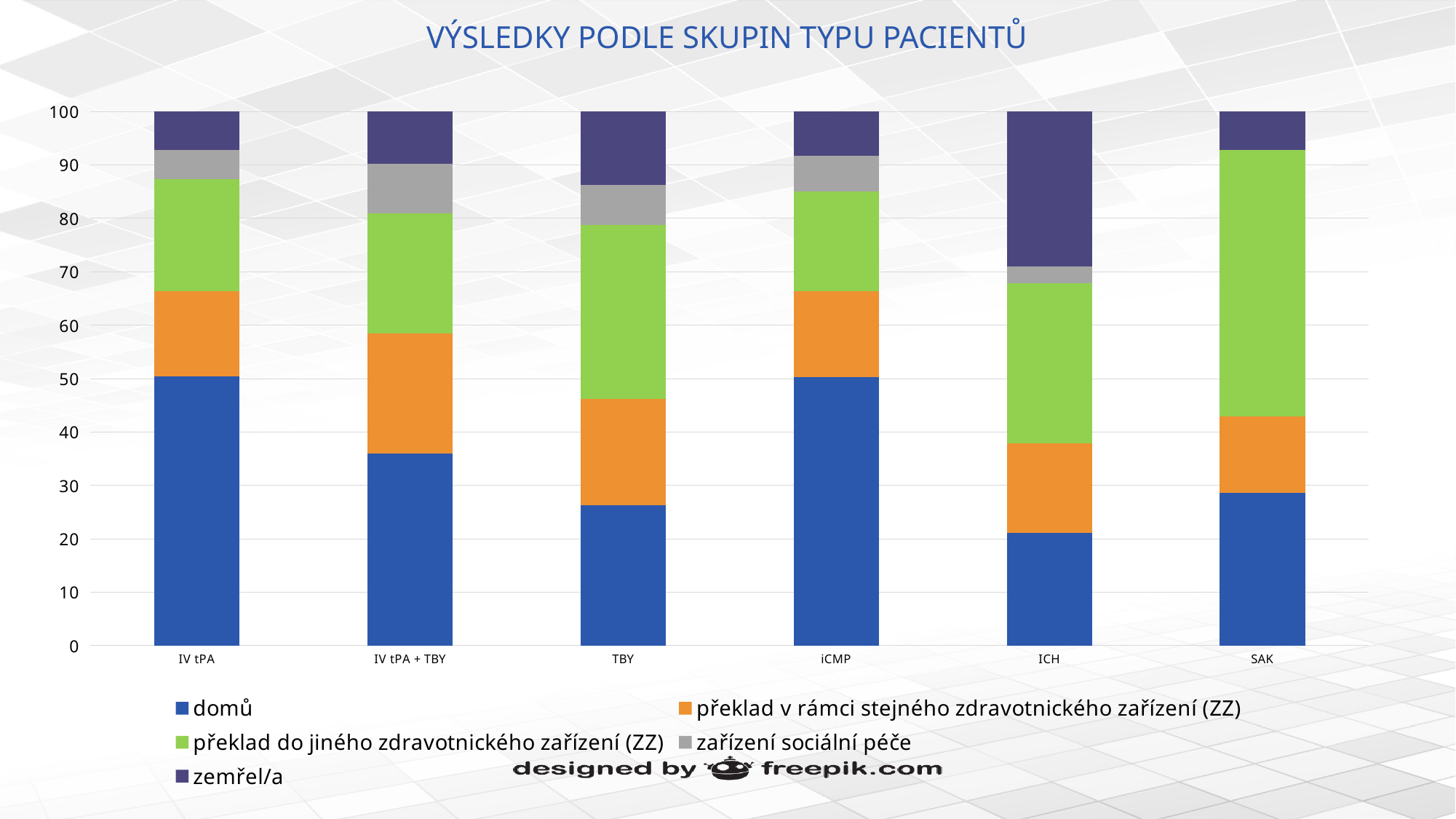
Which colour represents the series 'zemřel/a' in the legend? dark purple Is the value for 'domů' in the ICH group greater or less than 30? less Which patient group has the largest 'překlad do jiného zdravotnického zařízení (ZZ)' segment? SAK Which patient group has the largest 'zemřel/a' segment? ICH What kind of chart is shown on the slide? stacked bar chart How many series does the legend list? 5 Which is larger, the 'domů' value for IV tPA + TBY or for ICH? IV tPA + TBY How many patient groups (categories) are shown on the x axis? 6 What is the title of the chart? VÝSLEDKY PODLE SKUPIN TYPU PACIENTŮ Is the value for 'domů' in the IV tPA + TBY group greater or less than 30? greater Which is larger, the 'zemřel/a' segment for ICH or for SAK? ICH Which patient group has the lowest value for 'domů'? ICH